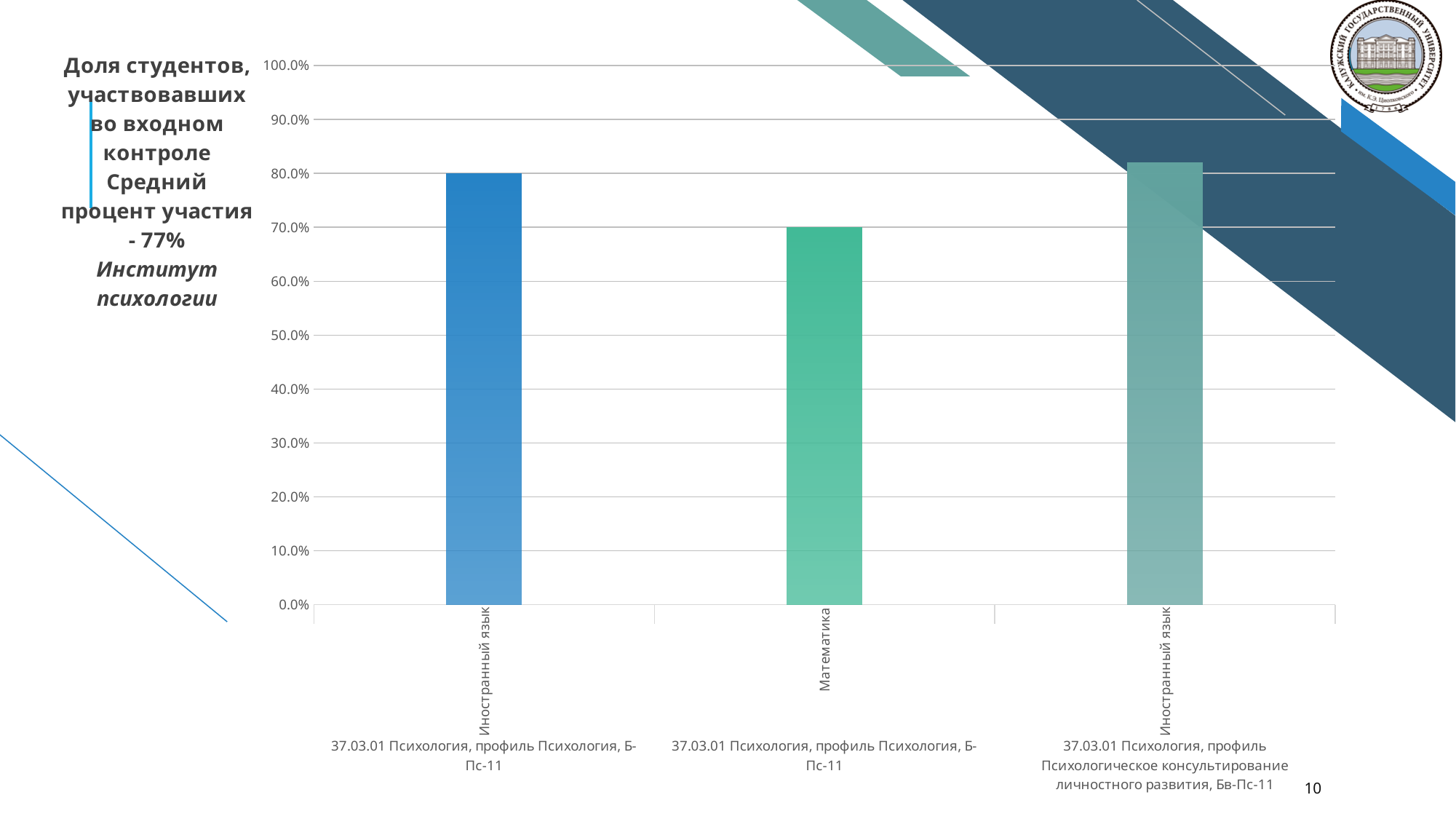
Is the value for Математика (Б-Пс-11) greater or less than 60.0%? greater What is the average participation percentage stated in the text next to the chart? 77% What is the value for Математика in 37.03.01 Психология, профиль Психология, Б-Пс-11? 70.0% Which is larger: the value for Иностранный язык (Б-Пс-11) or the value for Математика (Б-Пс-11)? Иностранный язык (Б-Пс-11) What is the value for Иностранный язык in 37.03.01 Психология, профиль Психология, Б-Пс-11? 80.0% Which subject has the lowest bar in the chart? Математика What is the difference between the value for Иностранный язык (Б-Пс-11) and the value for Математика (Б-Пс-11)? 10.0% What is the highest value shown on the vertical axis of the chart? 100.0% Is the value for Иностранный язык in the Бв-Пс-11 group (Психологическое консультирование личностного развития) greater or less than 80.0%? greater How many bars are plotted in the chart? 3 Which bar is the highest in the chart? Иностранный язык, 37.03.01 Психология, профиль Психологическое консультирование личностного развития, Бв-Пс-11 What kind of chart is shown on the slide? bar chart